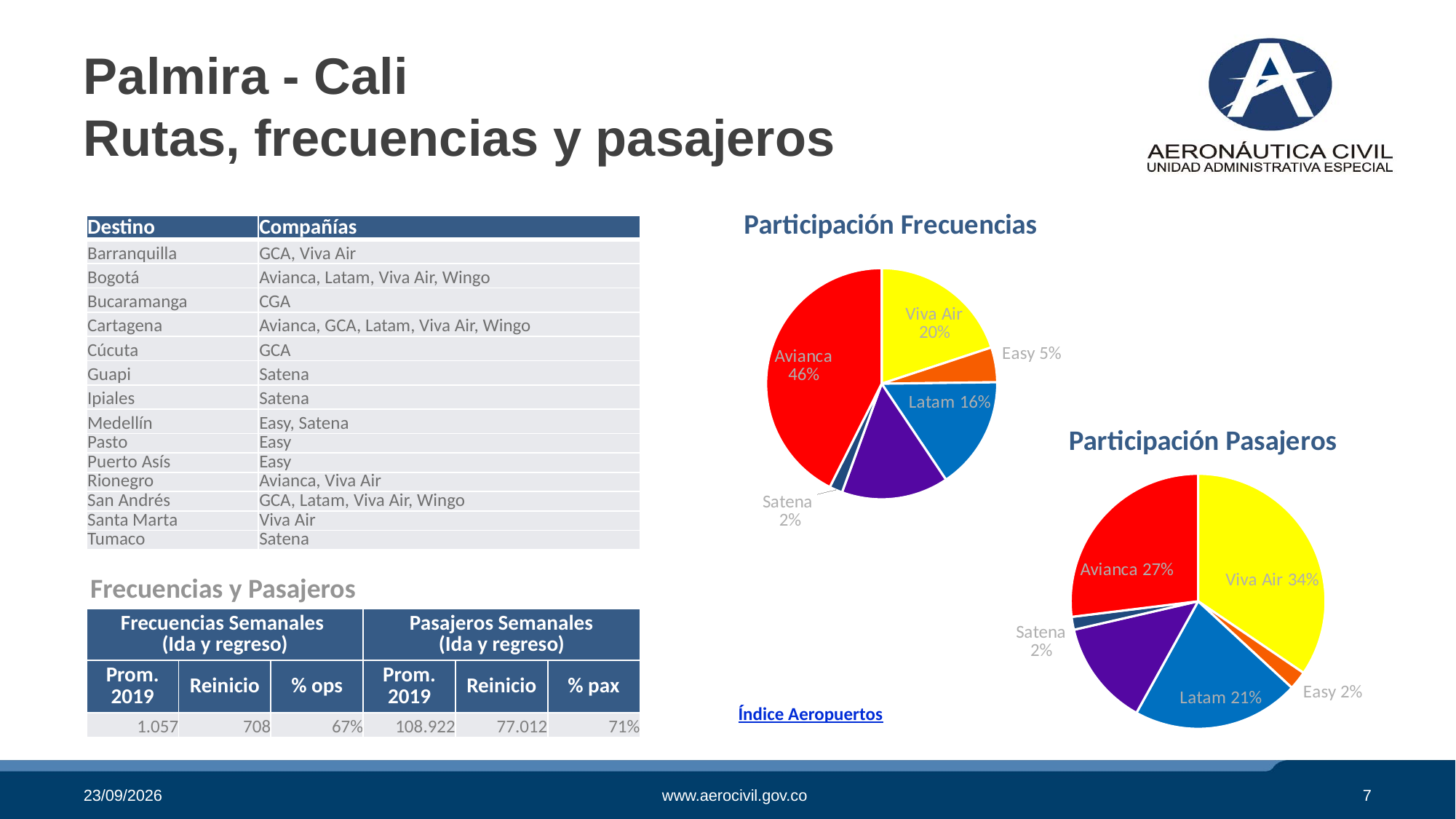
In the 'Participación Frecuencias' pie chart, which labeled airline has the largest share? Avianca In the 'Participación Frecuencias' pie chart, what colour is the Avianca slice? Red In the 'Participación Pasajeros' pie chart, which labeled airline has the largest share? Viva Air In the 'Participación Frecuencias' pie chart, what share does Latam have? 16% In the 'Participación Pasajeros' pie chart, what share does Latam have? 21% In the 'Participación Pasajeros' pie chart, which is larger, the share of Avianca or the share of Latam? Avianca In the 'Participación Pasajeros' pie chart, what is the difference between the shares of Viva Air and Avianca? 7% In the 'Participación Frecuencias' pie chart, which labeled airline has the smallest share? Satena What type of chart is 'Participación Frecuencias'? Pie chart In the 'Participación Pasajeros' pie chart, what share does Viva Air have? 34% In the 'Participación Frecuencias' pie chart, what share does Avianca have? 46% In the 'Participación Frecuencias' pie chart, what is the difference between the shares of Viva Air and Easy? 15%